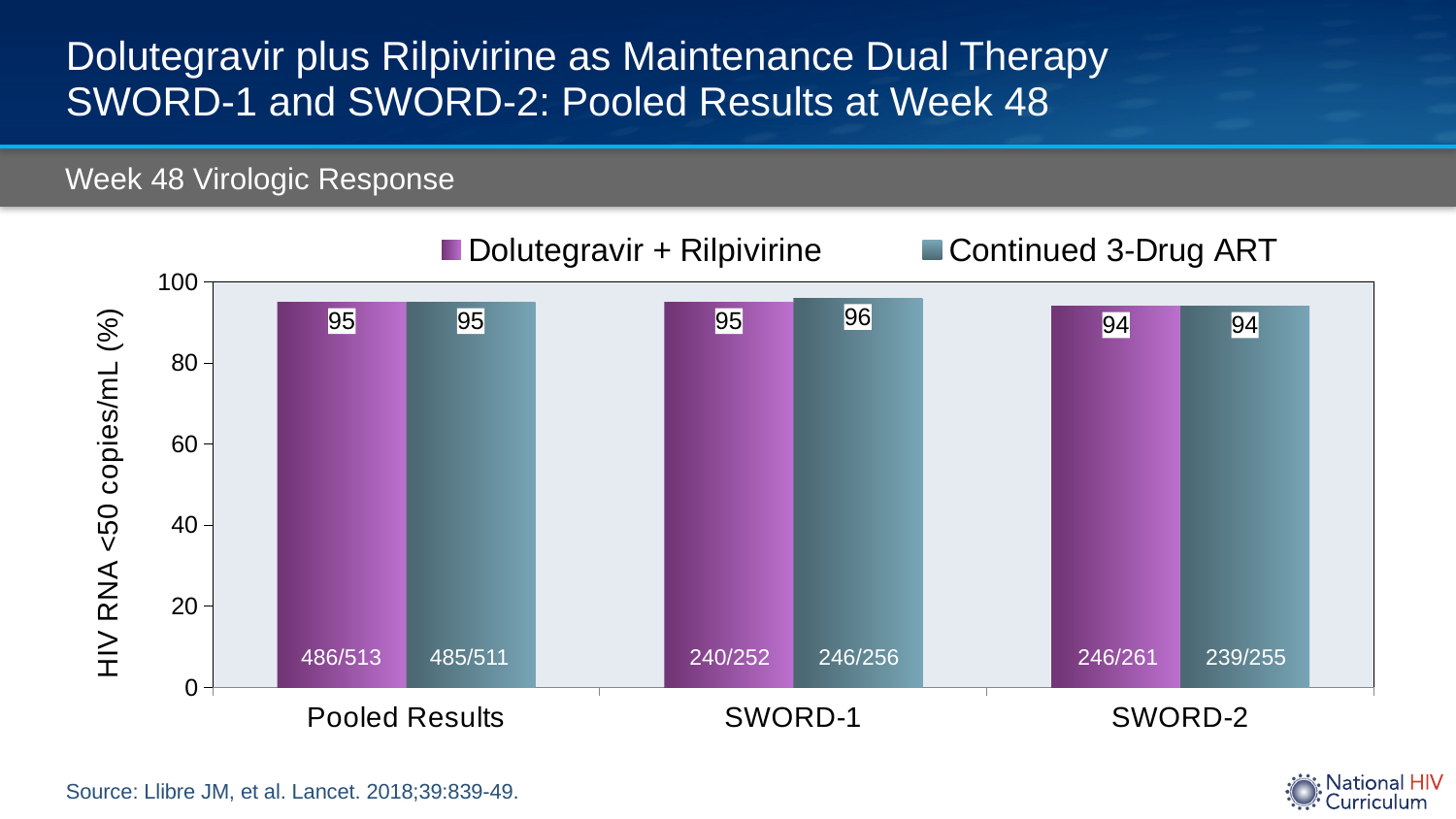
What fraction is printed on the Continued 3-Drug ART bar for SWORD-2? 239/255 What kind of chart is shown on the slide? Bar chart How many series does the legend list? 2 What is the value for Continued 3-Drug ART in the SWORD-1 category? 96 What is the title of the y axis? HIV RNA <50 copies/mL (%) What is the value for Dolutegravir + Rilpivirine in the Pooled Results category? 95 How many categories are shown on the x axis? 3 Is the value for Dolutegravir + Rilpivirine in SWORD-2 greater or less than 80? greater What is the difference between the Continued 3-Drug ART value and the Dolutegravir + Rilpivirine value in SWORD-1? 1 What is the value for Dolutegravir + Rilpivirine in the SWORD-2 category? 94 What fraction is printed on the Dolutegravir + Rilpivirine bar for Pooled Results? 486/513 What is the chart's title? Week 48 Virologic Response